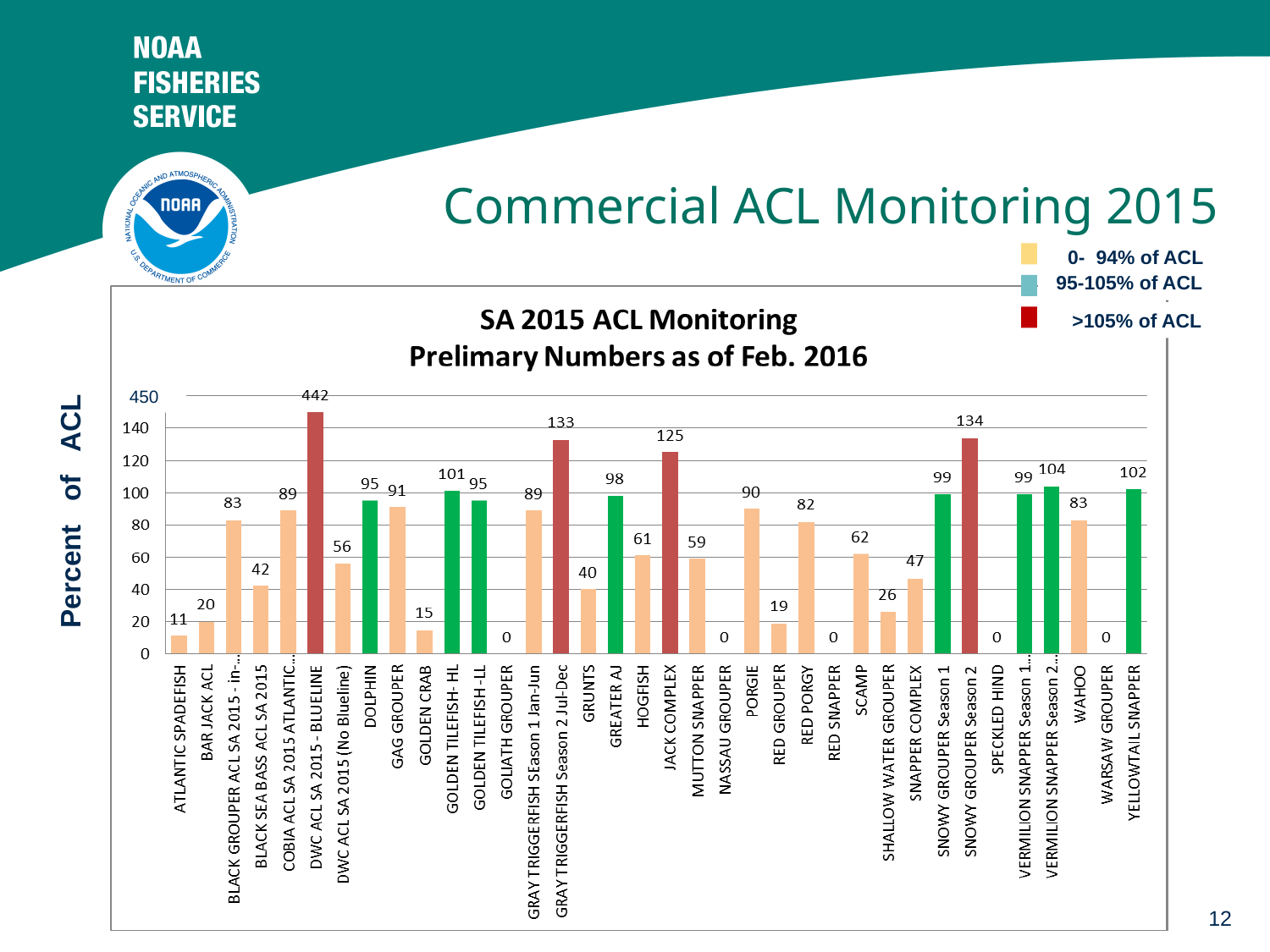
According to the legend, what colour represents >105% of ACL? red What is the difference between the values for VERMILION SNAPPER Season 2 and VERMILION SNAPPER Season 1? 5 What is the value for GOLDEN CRAB? 15 What is the value for SNOWY GROUPER Season 2? 134 What is the value for JACK COMPLEX? 125 Which is larger, the value for HOGFISH or the value for SCAMP? SCAMP What is the value for DOLPHIN? 95 How many categories have a value of 0? 5 How many categories are shown on the x axis? 36 What is the difference between the values for GRAY TRIGGERFISH Season 2 Jul-Dec and GRAY TRIGGERFISH Season 1 Jan-Jun? 44 Which category has the highest value? DWC ACL SA 2015 - BLUELINE What kind of chart is this? bar chart